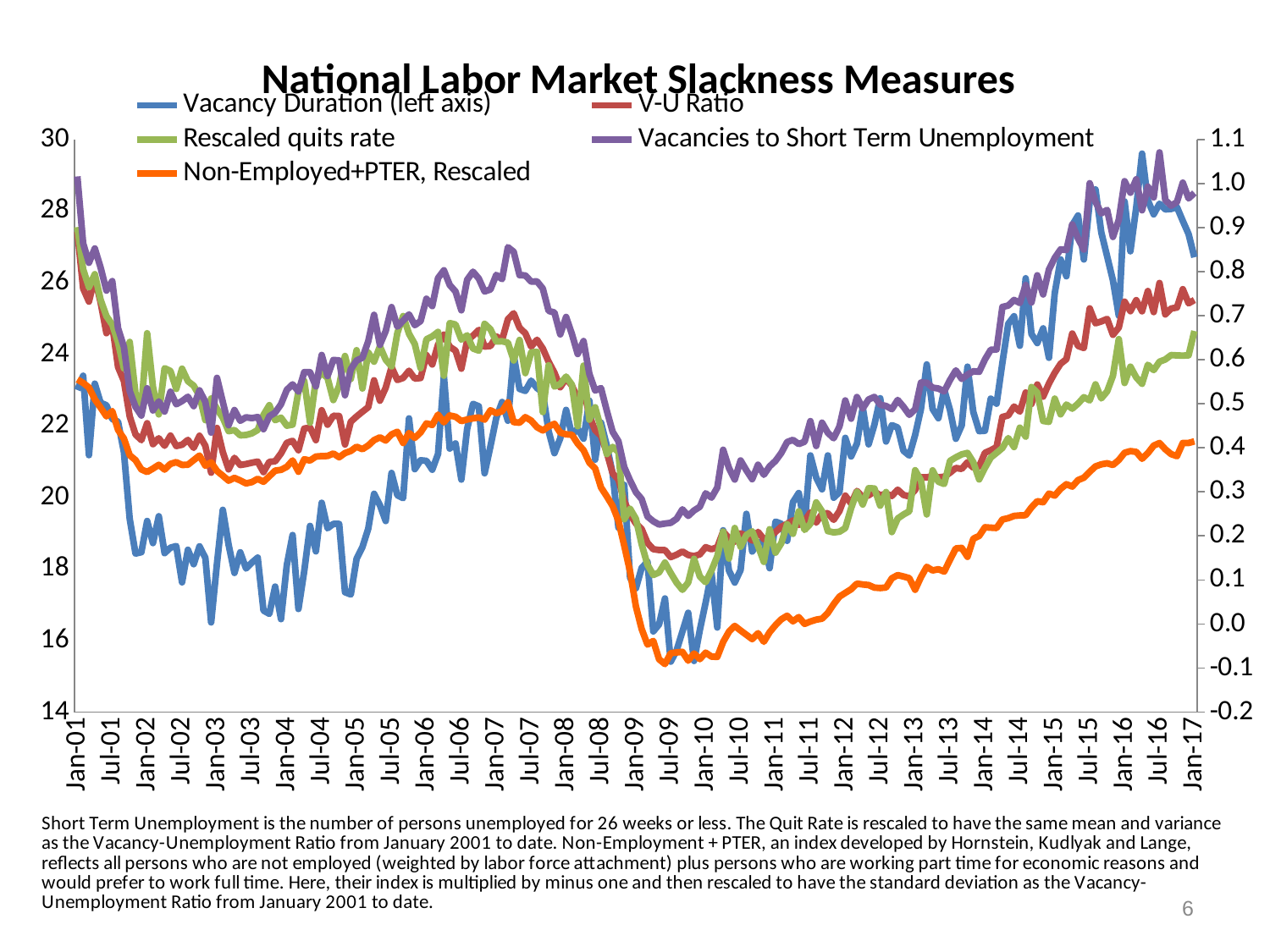
Is the peak value of Vacancy Duration around Jan-16 greater or less than 28 on the left axis? greater Is the value of Non-Employed+PTER, Rescaled around Jul-09 greater or less than 0.0 on the right axis? less Is the value of Vacancies to Short Term Unemployment at Jan-01 greater or less than 0.9 on the right axis? greater What kind of chart is shown on the slide? Line chart Does Vacancy Duration rise or fall from Jan-07 to Jul-09? fall How many series does the legend list? 5 Which series is plotted against the left axis according to the legend? Vacancy Duration At Jan-17, which is larger on the right axis: the V-U Ratio or the Rescaled quits rate? V-U Ratio What is the title of the chart? National Labor Market Slackness Measures Does the Non-Employed+PTER, Rescaled series rise or fall from Jan-10 to Jan-17? rise